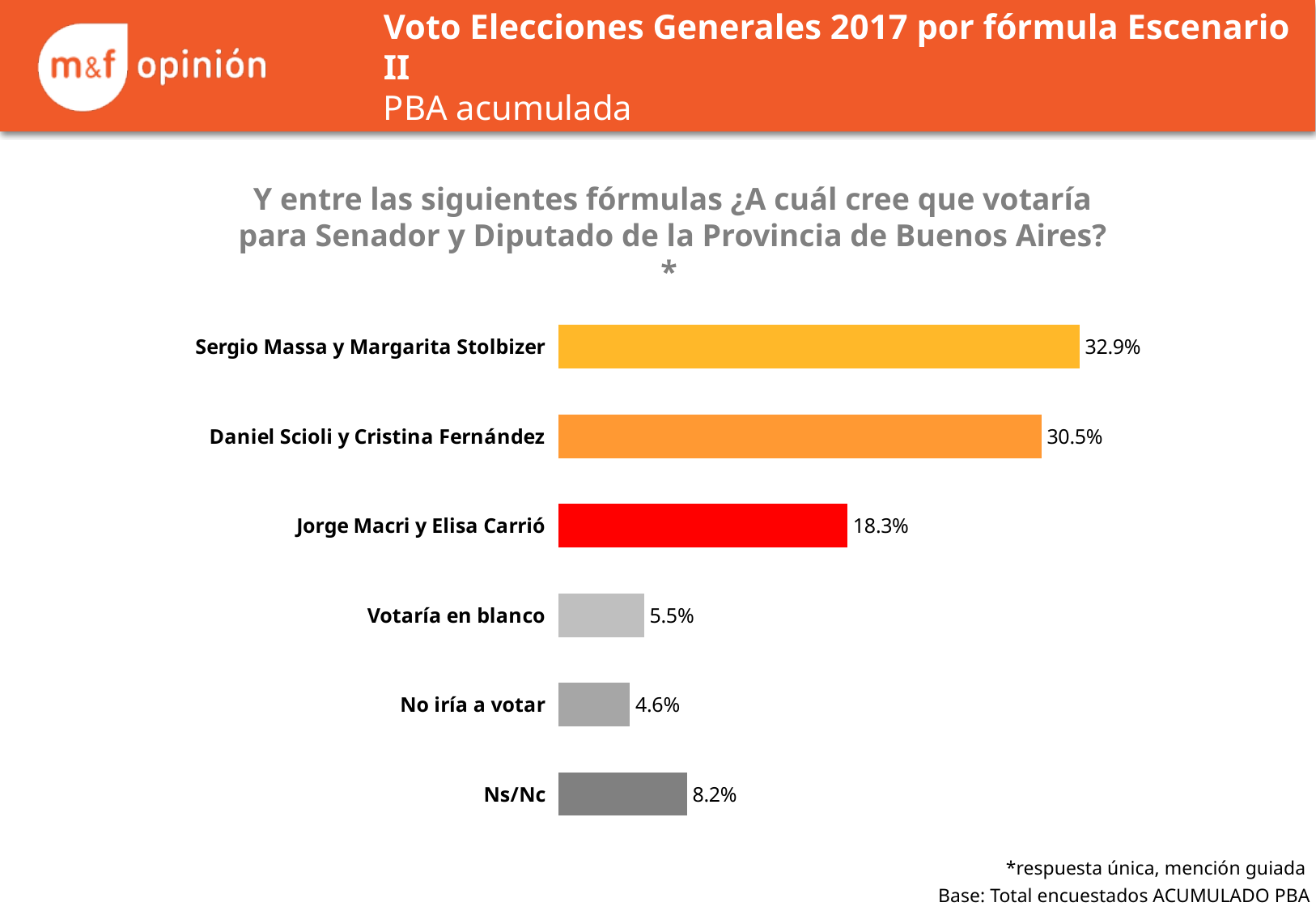
What percentage is shown for Ns/Nc? 8.2% What is the difference in percentage points between Daniel Scioli y Cristina Fernández and Jorge Macri y Elisa Carrió? 12.2 Which option has the lowest percentage? No iría a votar What is the difference in percentage points between Sergio Massa y Margarita Stolbizer and Daniel Scioli y Cristina Fernández? 2.4 What kind of chart is shown on the slide? Bar chart What percentage is shown for Sergio Massa y Margarita Stolbizer? 32.9% What percentage is shown for Jorge Macri y Elisa Carrió? 18.3% Which is larger, the value for Jorge Macri y Elisa Carrió or the value for Daniel Scioli y Cristina Fernández? Daniel Scioli y Cristina Fernández Which option has the highest percentage? Sergio Massa y Margarita Stolbizer How many categories are shown in the chart? 6 Which is larger, the value for Votaría en blanco or the value for Ns/Nc? Ns/Nc What colour is the bar for Jorge Macri y Elisa Carrió? Red